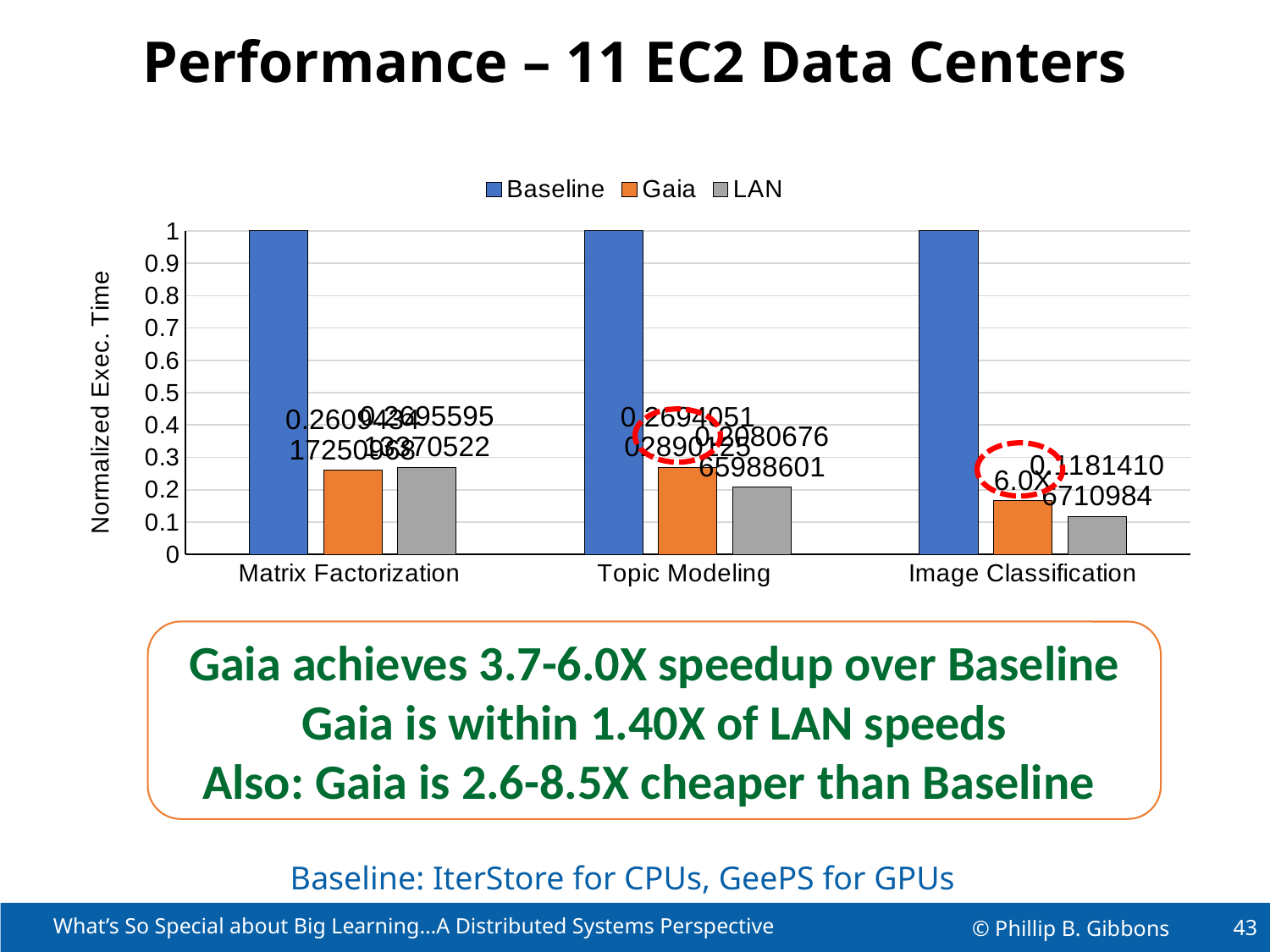
What is the label of the vertical axis of the chart? Normalized Exec. Time What is the Baseline value for Image Classification? 1 How many categories are shown on the x axis of the chart? 3 Which series has the lowest value for Image Classification? LAN What is the Baseline value for Topic Modeling? 1 For Image Classification, which is larger: the Gaia value or the LAN value? Gaia For Topic Modeling, which is larger: the Baseline value or the Gaia value? Baseline Is the LAN value for Image Classification greater or less than 0.2? less Is the Gaia value for Image Classification greater or less than 0.2? less How many series does the chart legend list? 3 Is the Gaia value for Matrix Factorization greater or less than 0.2? greater What kind of chart is shown on the slide? bar chart